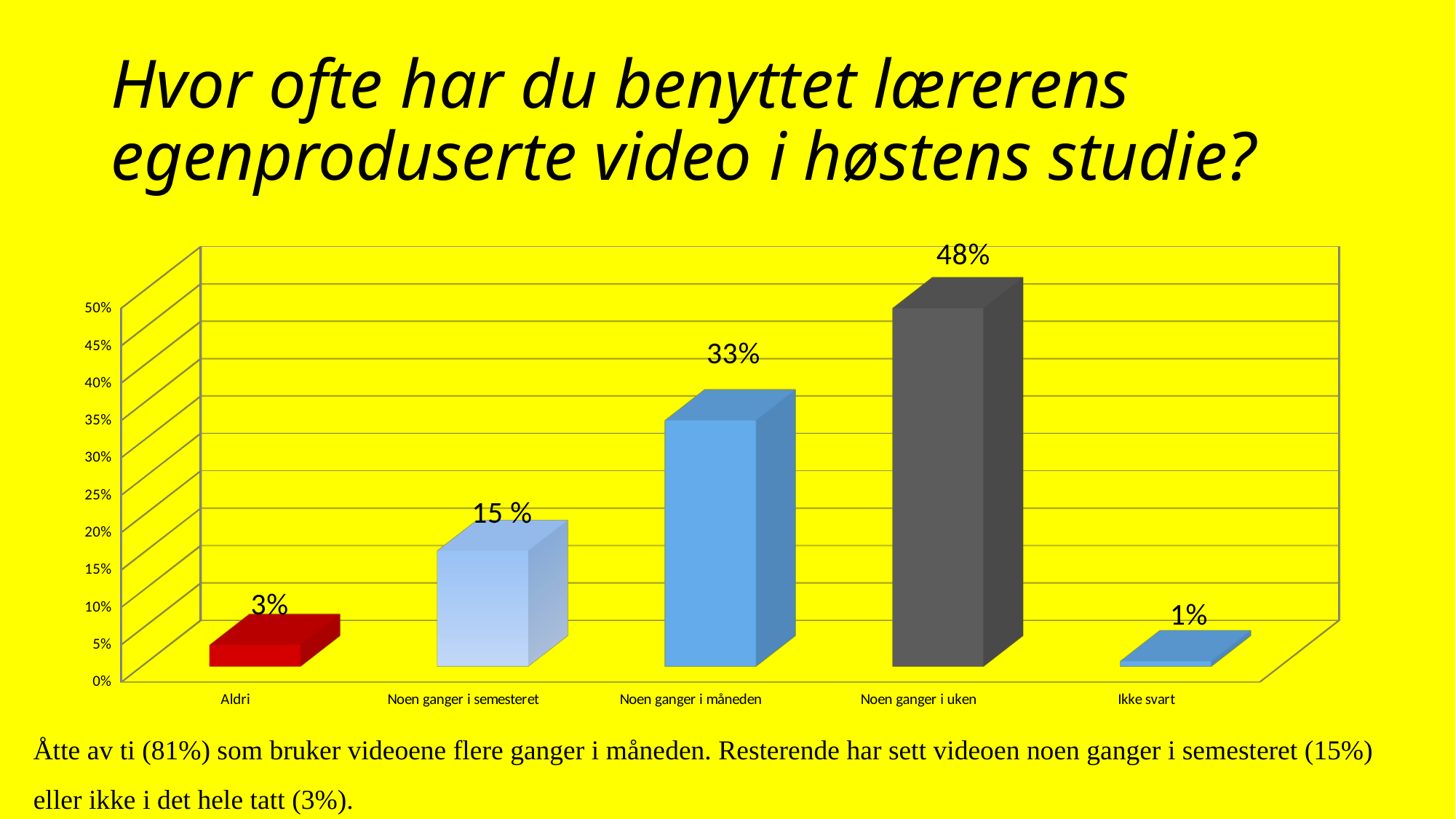
What is the difference between the values for "Noen ganger i uken" and "Noen ganger i måneden"? 15% Is the value for "Noen ganger i måneden" greater or less than 30%? greater Which category has the highest value? Noen ganger i uken What kind of chart is shown on the slide? bar chart What colour is the bar for "Aldri"? red What is the value for "Noen ganger i uken"? 48% What is the value for "Aldri"? 3% Which category has the lowest value? Ikke svart What is the value for "Noen ganger i måneden"? 33% How many categories are shown on the x axis? 5 Which is larger, the value for "Noen ganger i semesteret" or the value for "Aldri"? Noen ganger i semesteret What is the value for "Ikke svart"? 1%